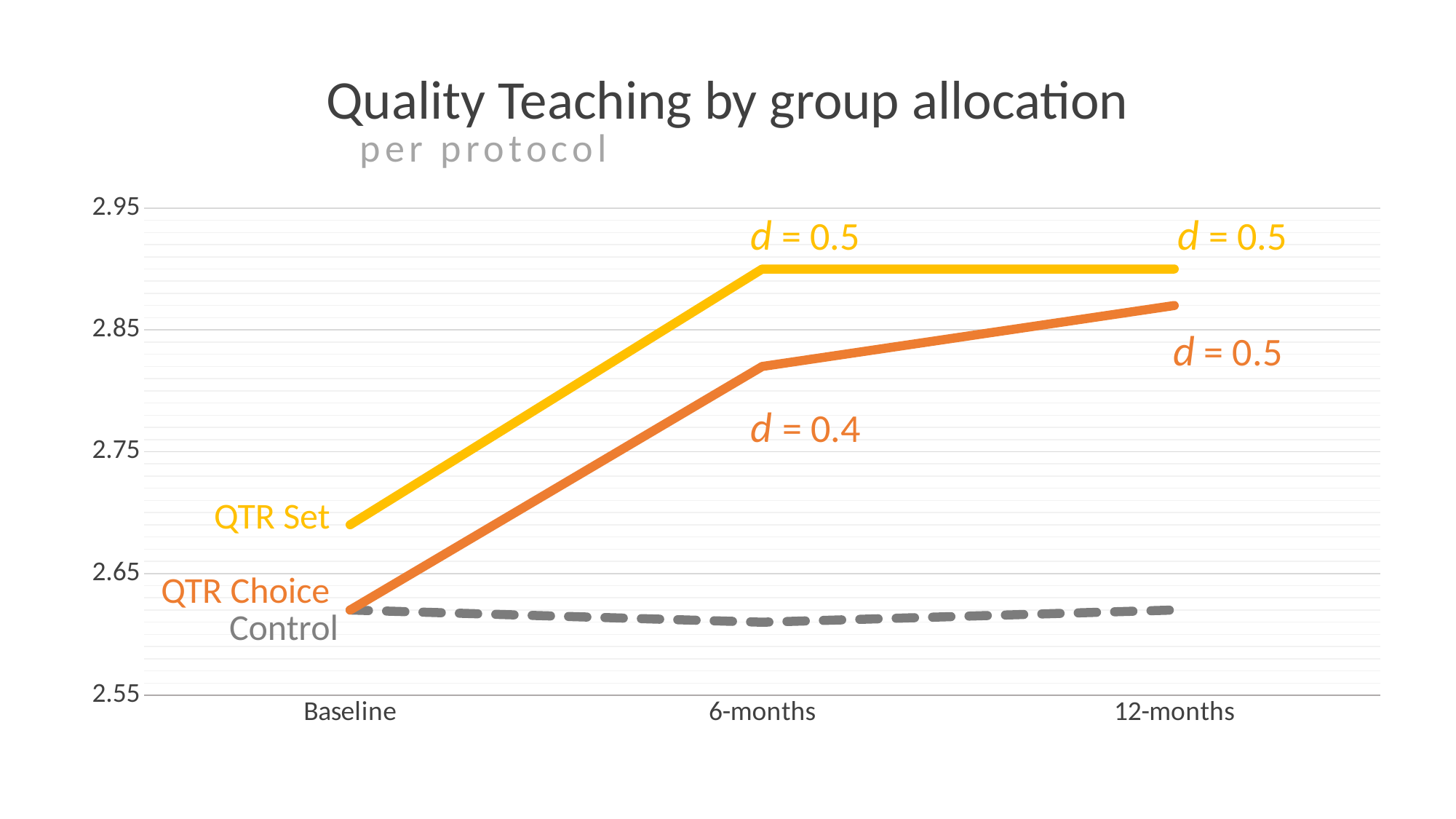
At 6-months, which is larger: the value for QTR Set or the value for QTR Choice? QTR Set Is the value for Control at 12-months greater or less than 2.65? less What kind of chart is shown on the slide? line chart What effect size (d) is printed for QTR Choice at 6-months? d = 0.4 Is the value for QTR Choice at 12-months greater or less than 2.75? greater What is the subtitle printed under the chart title? per protocol Which group has the lowest value at 6-months? Control How many groups (series) are plotted on the chart? 3 Is the value for QTR Set at 6-months greater or less than 2.85? greater Does the QTR Choice line rise or fall from Baseline to 12-months? rises Which group has the highest value at 12-months? QTR Set How many time points are shown on the x axis? 3